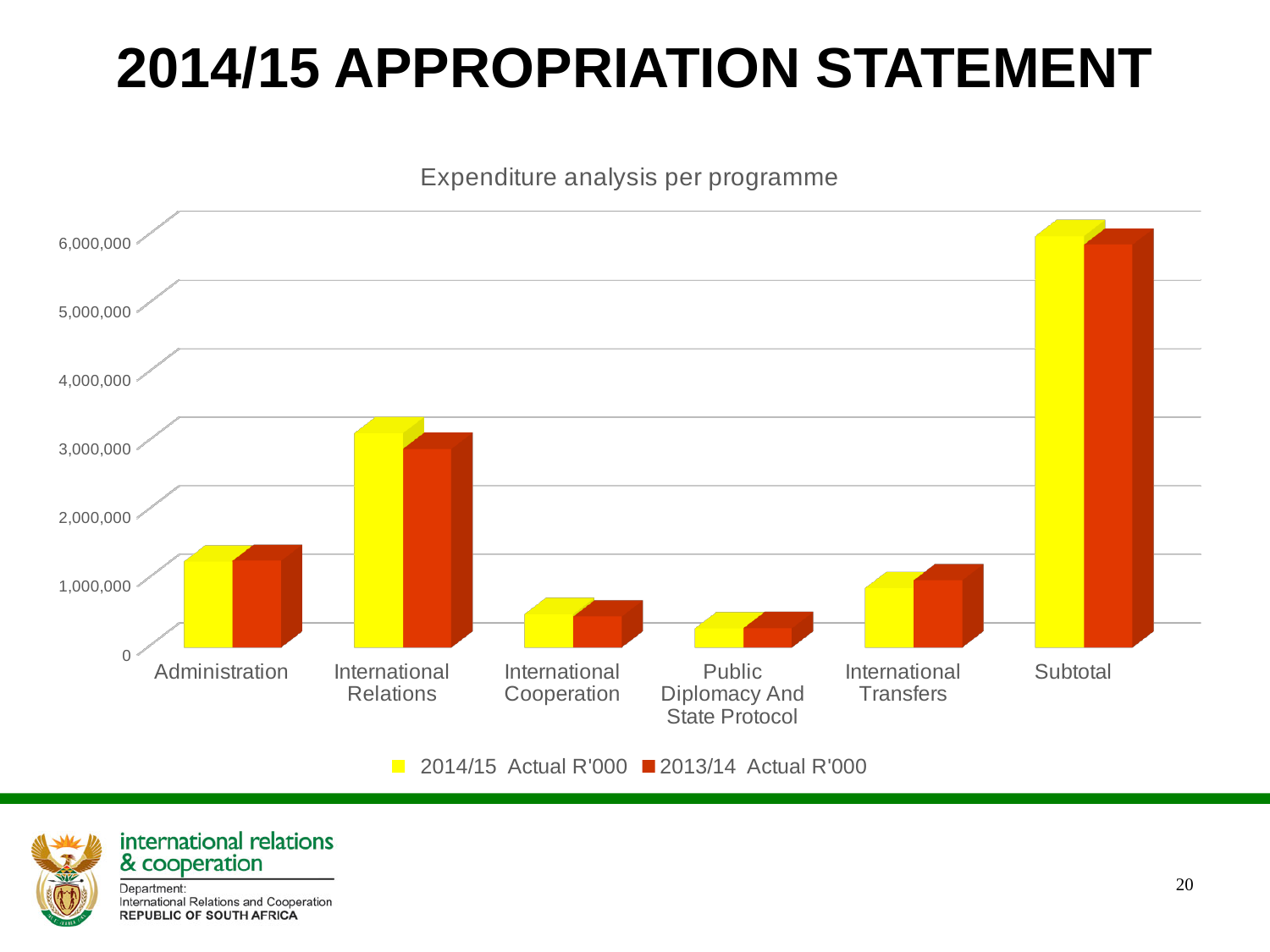
Which has the larger 2014/15 Actual R'000 value, Administration or International Relations? International Relations Which category has the highest 2014/15 Actual R'000 value? Subtotal What kind of chart is shown on the slide? bar chart Which category has the lowest 2013/14 Actual R'000 value? Public Diplomacy And State Protocol What is the title of the chart? Expenditure analysis per programme How many series does the legend list? 2 Is the 2014/15 Actual R'000 value for Subtotal greater or less than 5,000,000? greater Is the 2014/15 Actual R'000 value for International Relations greater or less than 2,000,000? greater How many programme categories are shown on the x axis? 6 Which colour represents the 2014/15 Actual R'000 series? yellow Is the 2014/15 Actual R'000 value for International Cooperation greater or less than 1,000,000? less Which has the larger 2013/14 Actual R'000 value, International Cooperation or International Transfers? International Transfers